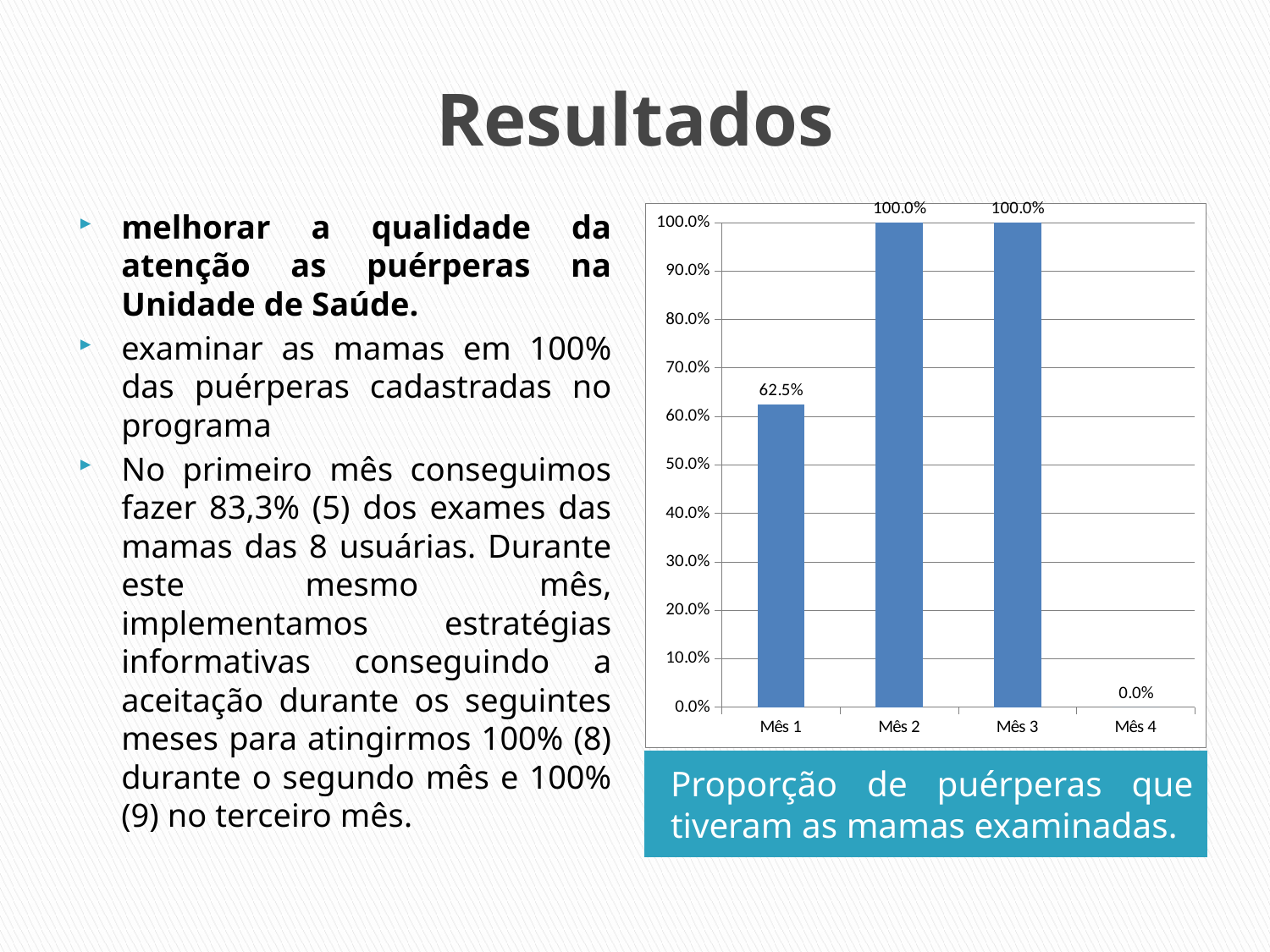
What is the value for Mês 3 in the chart? 100.0% Which month has the lowest value in the chart? Mês 4 How many months (categories) are shown on the x axis of the chart? 4 What is the value for Mês 1 in the chart? 62.5% Which is larger, the value for Mês 1 or the value for Mês 3? Mês 3 Is the value for Mês 1 greater or less than 50.0%? greater What kind of chart is shown on the slide? bar chart What is the value for Mês 4 in the chart? 0.0% Does the value rise or fall from Mês 1 to Mês 2? rise What is the caption shown below the chart? Proporção de puérperas que tiveram as mamas examinadas. What is the difference between the values for Mês 2 and Mês 1? 37.5% What is the value for Mês 2 in the chart? 100.0%